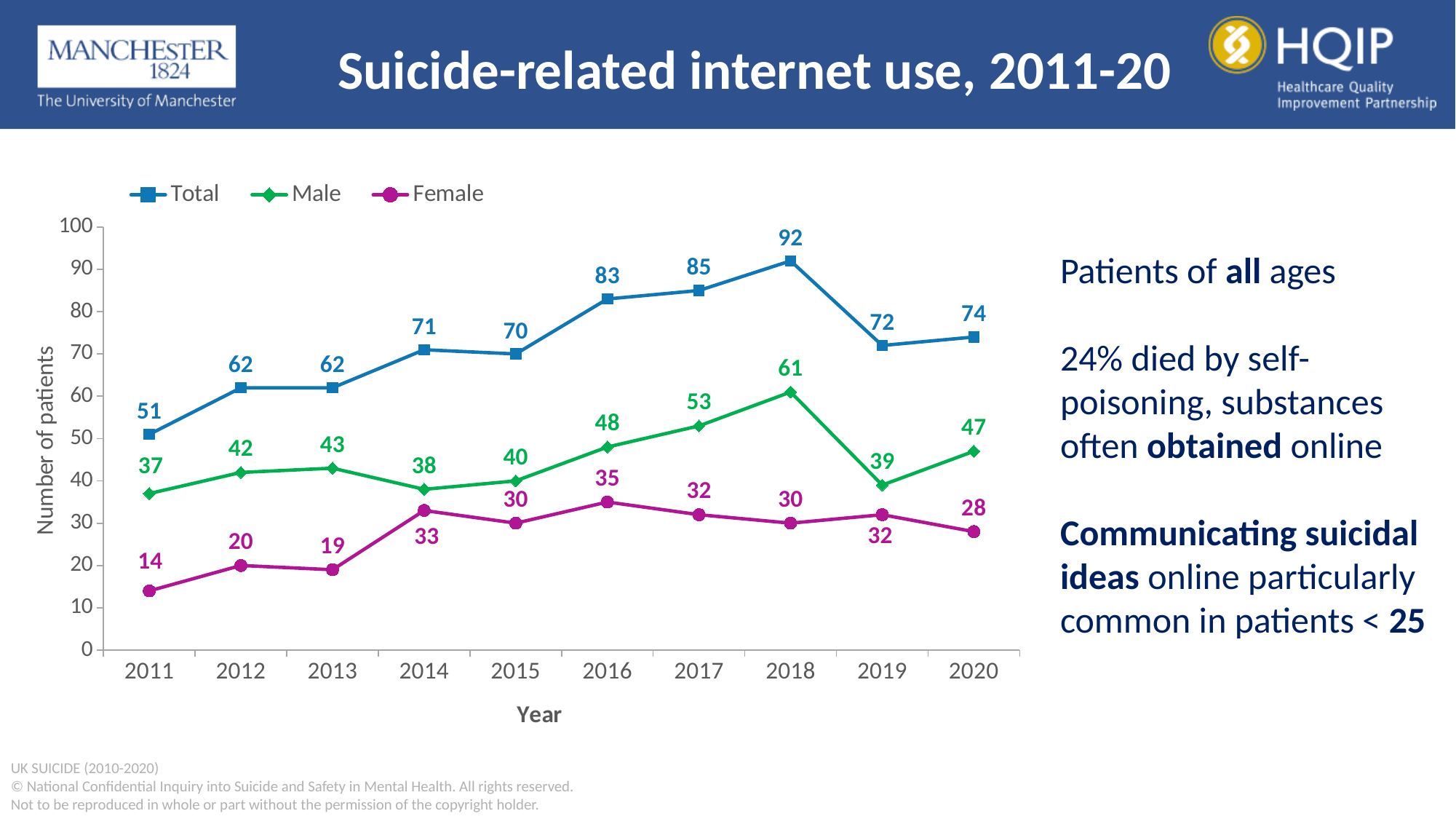
What kind of chart is shown on the slide? Line chart Is the Total value for 2016 greater or less than 80? greater What is the Male value in 2020? 47 How many years are shown on the x axis? 10 What is the Female value in 2011? 14 Which is larger, the Male value in 2017 or the Male value in 2019? Male value in 2017 In which year is the Total series highest? 2018 What is the label of the y axis? Number of patients In which year is the Female series lowest? 2011 What is the difference between the Total values in 2018 and 2019? 20 How many series does the legend list? 3 What is the Total number of patients in 2018? 92